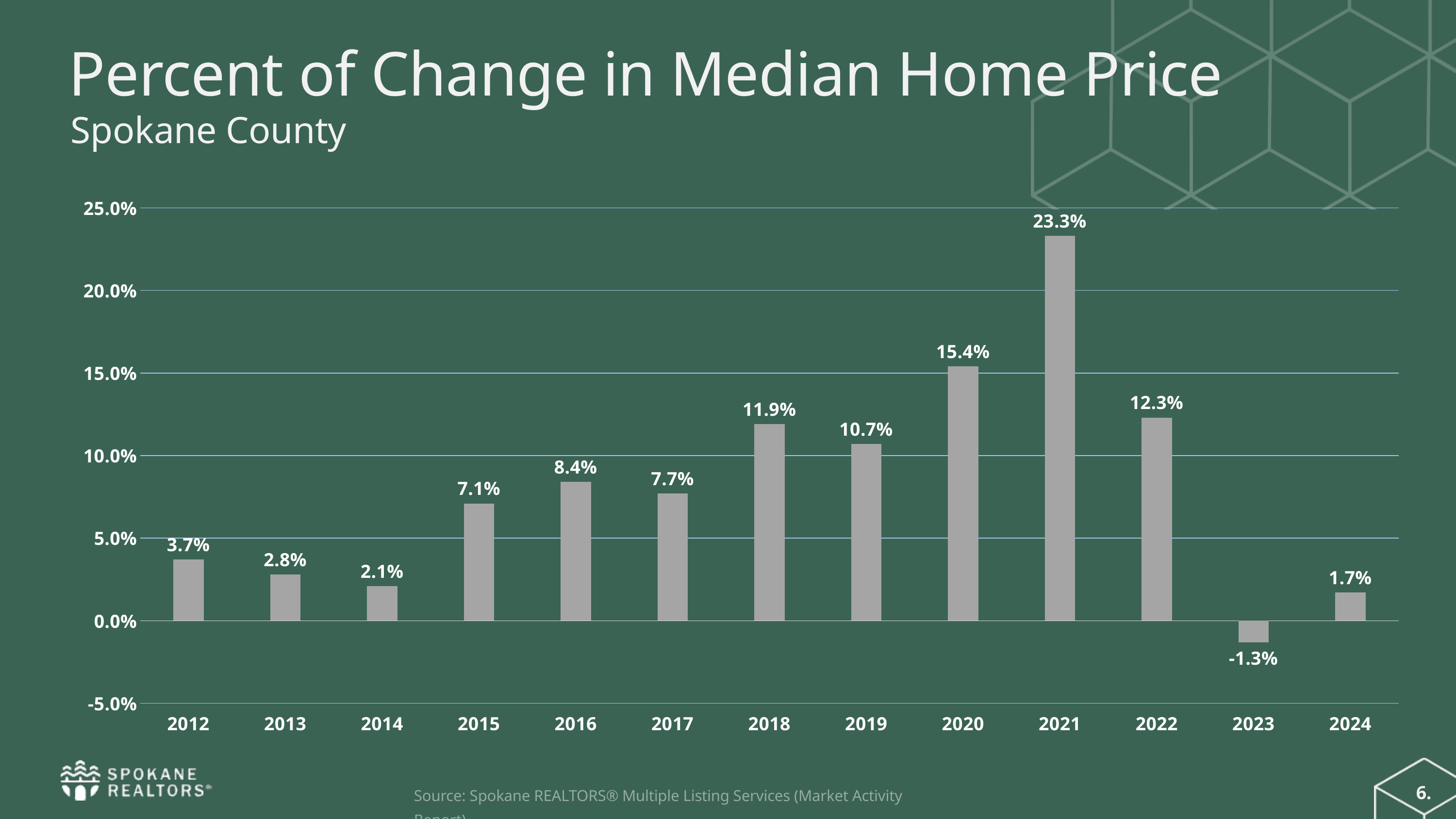
Which year has a larger percent change, 2018 or 2019? 2018 What is the difference between the percent change in 2020 and in 2019? 4.7% Which year has the highest percent change in median home price? 2021 Is the value for 2020 greater or less than 15.0%? greater What is the title of the chart on the slide? Percent of Change in Median Home Price Which year has the lowest percent change in median home price? 2023 What is the percent change in median home price for 2016? 8.4% How many years are shown on the x axis? 13 What is the percent change in median home price for 2023? -1.3% What is the percent change in median home price for 2021? 23.3% What kind of chart is shown on the slide? Bar chart What is the difference between the percent change in 2021 and in 2022? 11.0%